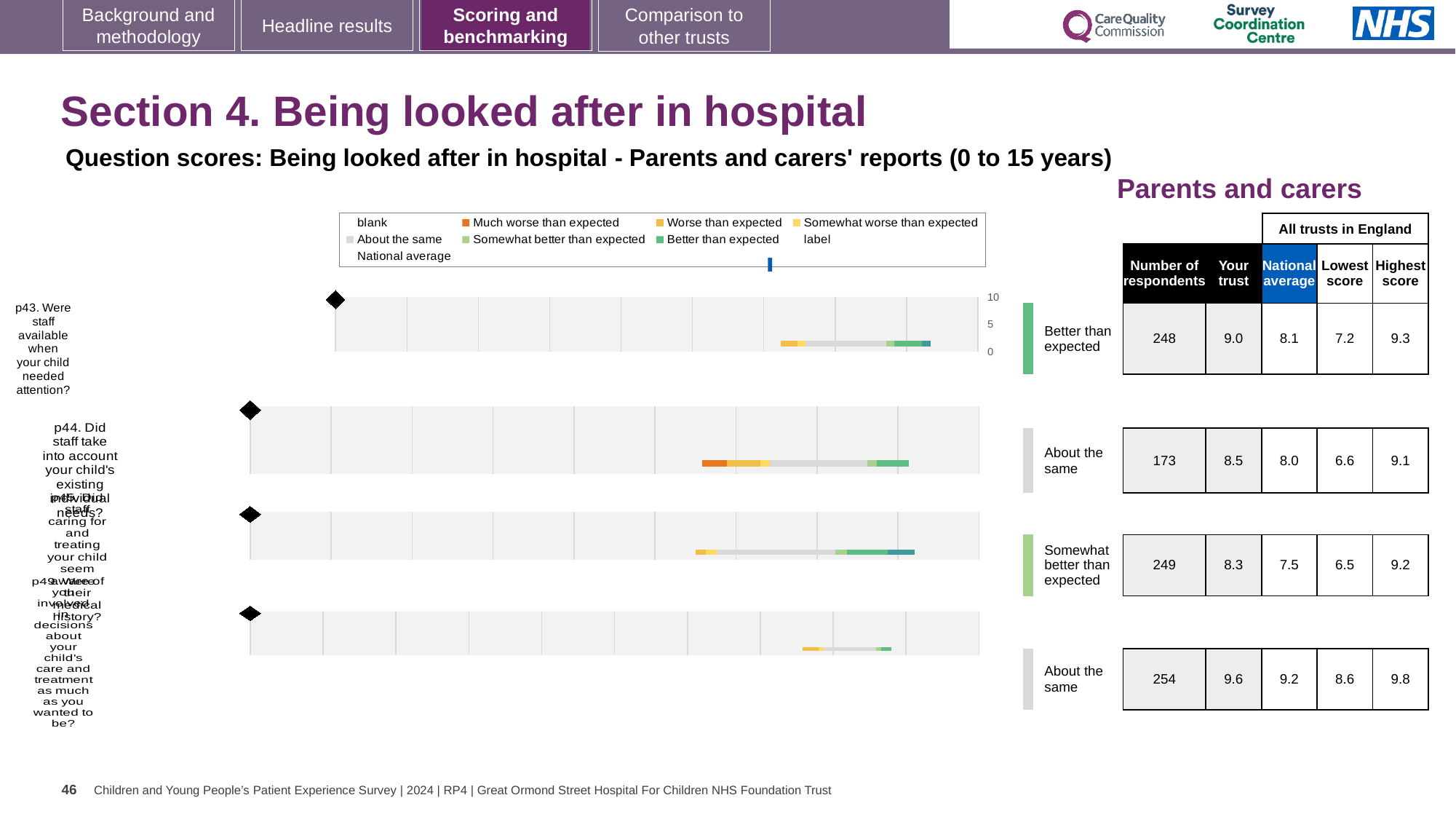
For the bottom chart (p49), what is the highest score among all trusts in England? 9.8 How many question charts are shown on the slide? 4 Which of the four charts has the highest 'Your trust' score? the bottom chart (p49), 9.6 For the top chart (p43. Were staff available when your child needed attention?), what is the 'Your trust' score? 9.0 Which of the four charts has the lowest 'Your trust' score? the third chart (p45), 8.3 For the top chart (p43. Were staff available when your child needed attention?), what is the number of respondents? 248 For the top chart (p43), which is larger: the 'Your trust' score or the national average? Your trust For the top chart (p43), what is the difference between the 'Your trust' score and the national average? 0.9 For the top chart (p43. Were staff available when your child needed attention?), what is the national average score? 8.1 What kind of chart is used to show the question scores on this slide? bar chart For the top chart (p43), is the 'Your trust' score greater or less than 5? greater What benchmark category is shown next to the top chart (p43)? Better than expected